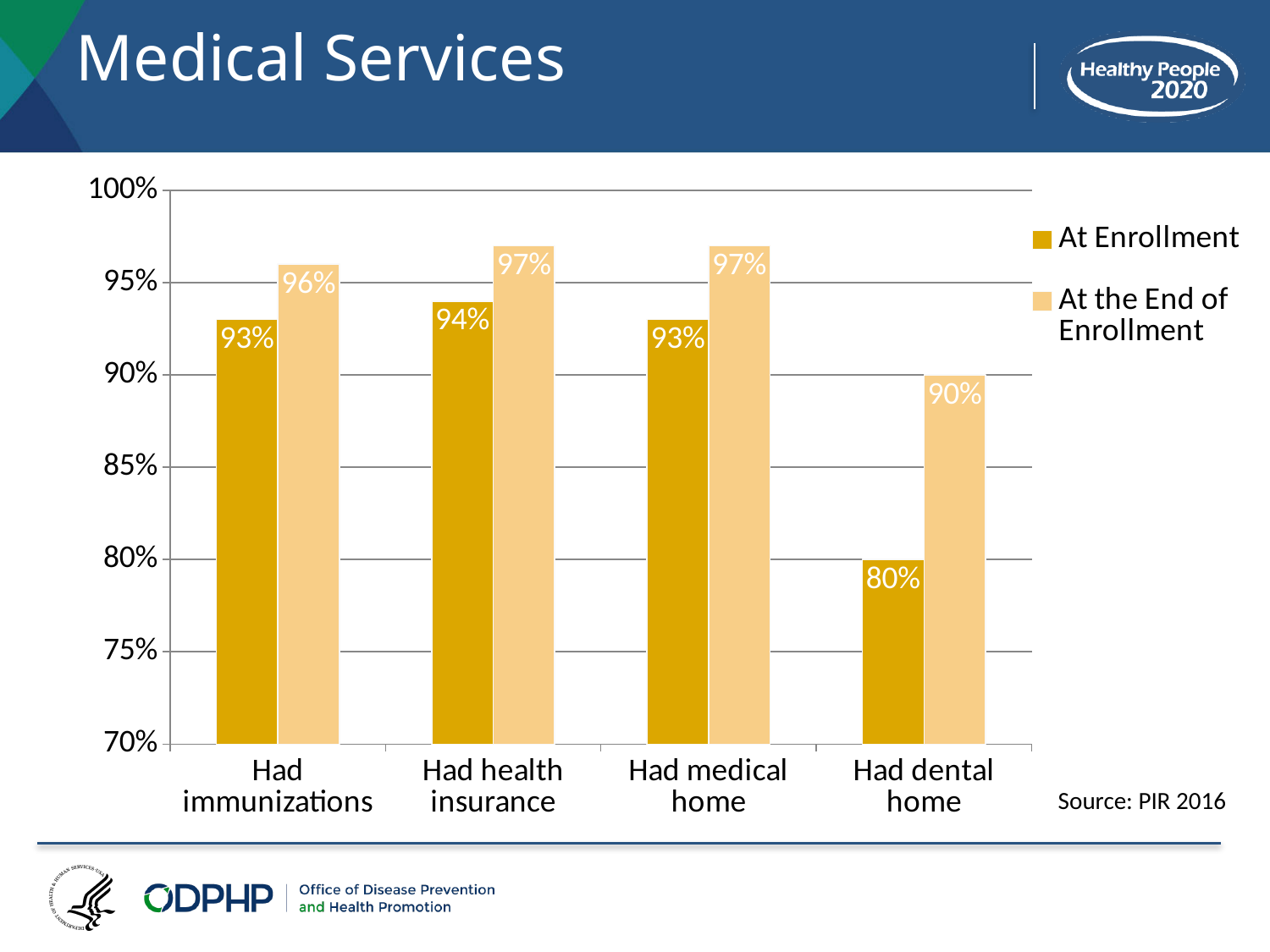
What is the value for Had dental home at the end of enrollment? 90% What kind of chart is shown on the slide? Bar chart What is the source cited for the chart? PIR 2016 Which category has the lowest value at enrollment? Had dental home What is the difference between the end-of-enrollment and at-enrollment values for Had immunizations? 3% Which is larger for Had medical home: the value at enrollment or at the end of enrollment? At the End of Enrollment How many series does the legend list? 2 Is the value for Had dental home at enrollment greater or less than 85%? less What is the value for Had immunizations at enrollment? 93% What is the value for Had health insurance at the end of enrollment? 97% How many categories are shown on the x axis? 4 What is the difference between the end-of-enrollment and at-enrollment values for Had dental home? 10%